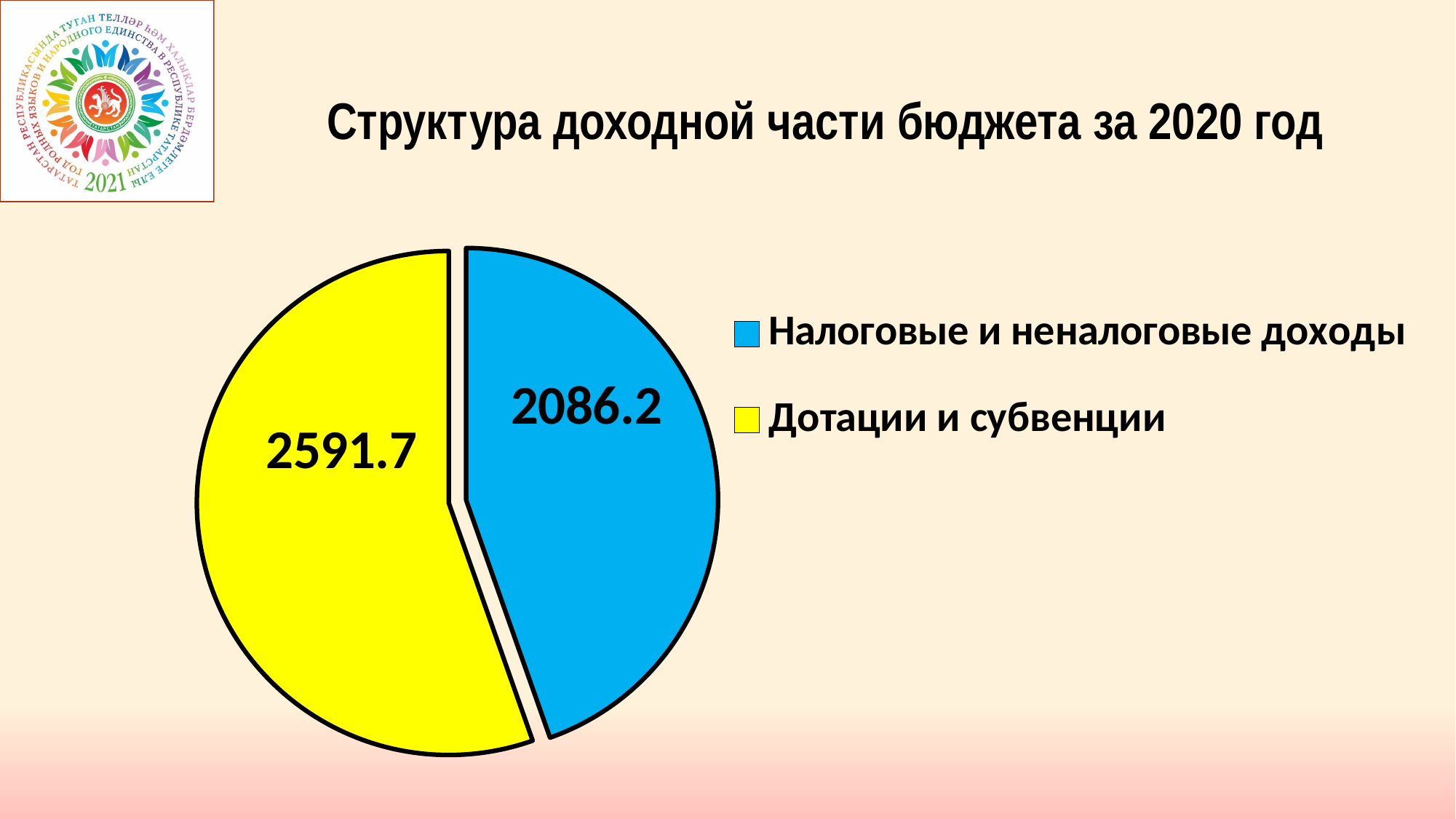
What is the difference between the values for Дотации и субвенции and Налоговые и неналоговые доходы? 505.5 What kind of chart is shown on the slide? Pie chart Which category has the smallest slice of the pie? Налоговые и неналоговые доходы What is the total of all slices in the pie chart? 4677.9 How many slices does the pie chart have? 2 What colour is the slice for Налоговые и неналоговые доходы? Blue What is the value for Налоговые и неналоговые доходы? 2086.2 What is the title of the chart? Структура доходной части бюджета за 2020 год Which is larger: Налоговые и неналоговые доходы or Дотации и субвенции? Дотации и субвенции Which category has the largest slice of the pie? Дотации и субвенции What share of the pie does Дотации и субвенции represent? 55.4% What is the value for Дотации и субвенции? 2591.7